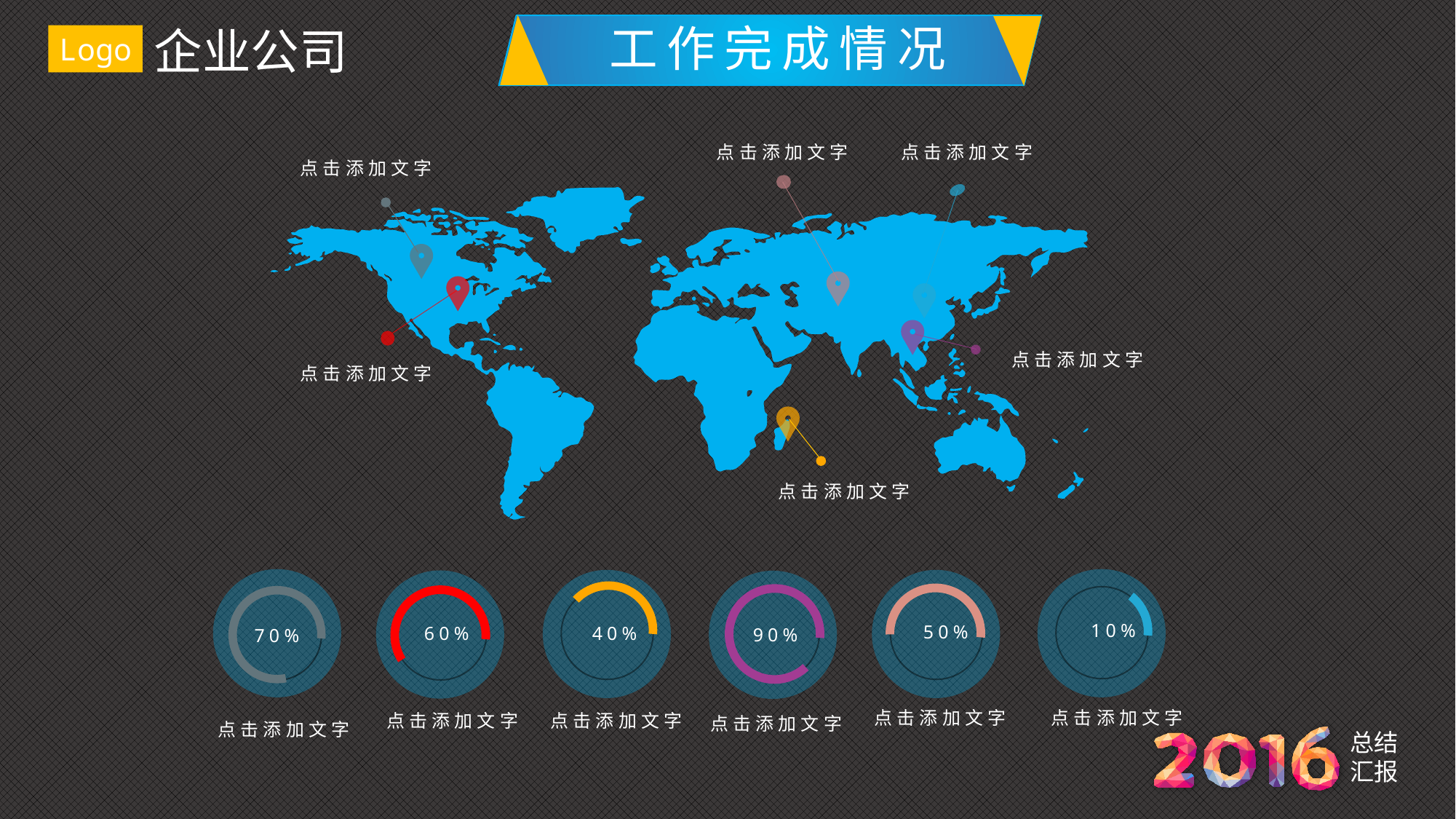
Which circular gauge shows the lowest percentage? The light blue gauge (10%) What percentage is shown in the purple circular gauge? 90% What percentage is shown in the rightmost (light blue) circular gauge? 10% What percentage is shown in the first (leftmost) circular gauge? 70% How many circular progress gauges are shown along the bottom of the slide? 6 What percentage is shown in the orange circular gauge? 40% What percentage is shown in the red circular gauge? 60% Which is larger, the percentage in the red gauge or the percentage in the orange gauge? The red gauge (60%) What is the difference between the percentages in the purple gauge and the light blue gauge? 80% Which circular gauge shows the highest percentage? The purple gauge (90%) What is the title of the slide shown in the banner at the top? 工作完成情况 What is the difference between the percentages in the first gauge and the fifth gauge from the left? 20%